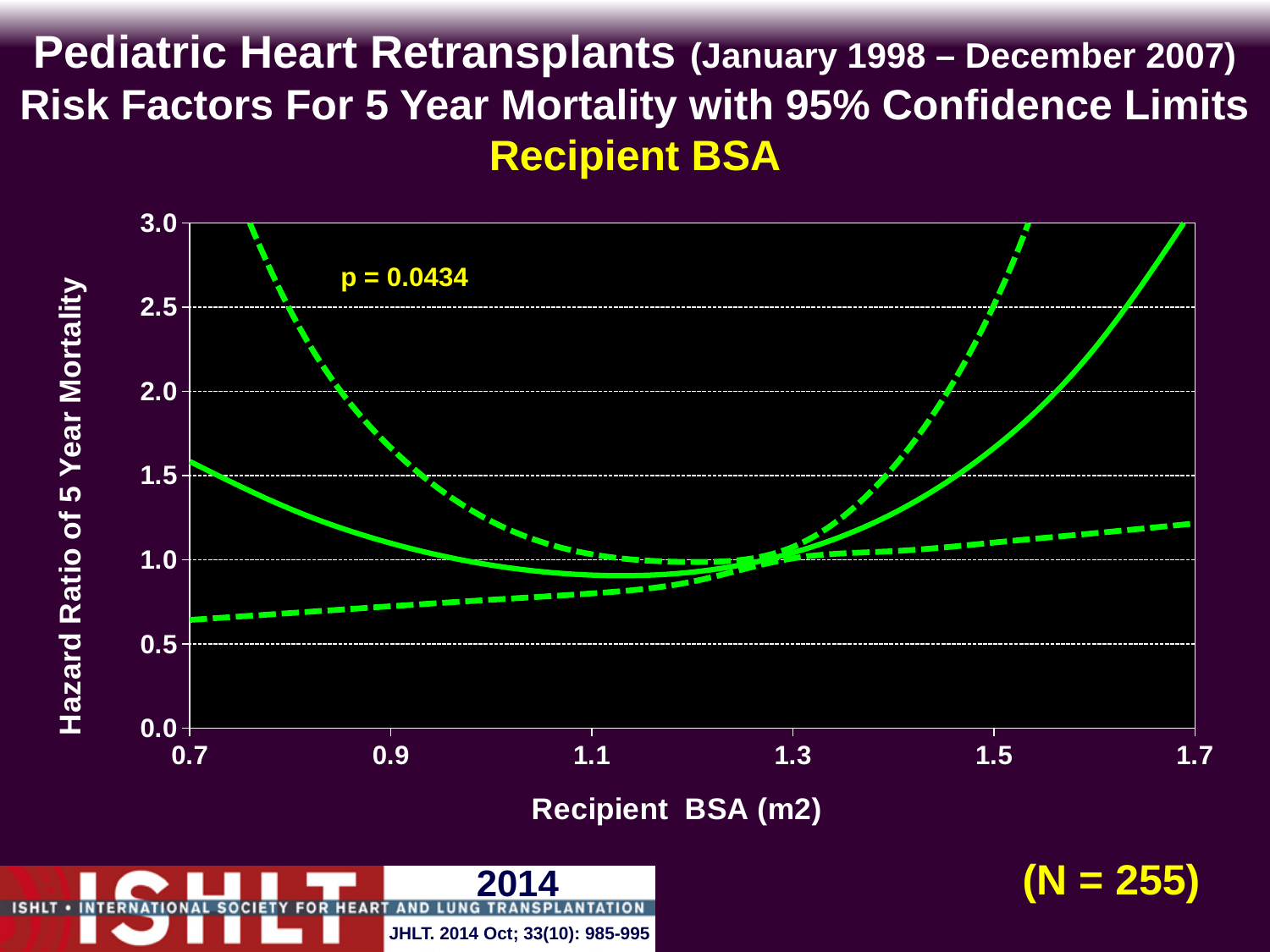
Is the upper dashed confidence limit at a recipient BSA of 0.9 greater or less than 2.0? less What p-value is shown on the chart? p = 0.0434 What is the sample size (N) shown on the slide? N = 255 What kind of chart is shown on the slide? line chart Does the solid hazard ratio line rise or fall as recipient BSA increases from 1.3 to 1.7? rise Is the hazard ratio on the solid line at a recipient BSA of 1.1 greater or less than 1.0? less How many lines are plotted on the chart? 3 Is the hazard ratio on the solid line at a recipient BSA of 0.7 greater or less than 1.0? greater Does the solid hazard ratio line rise or fall as recipient BSA increases from 0.7 to 1.1? fall